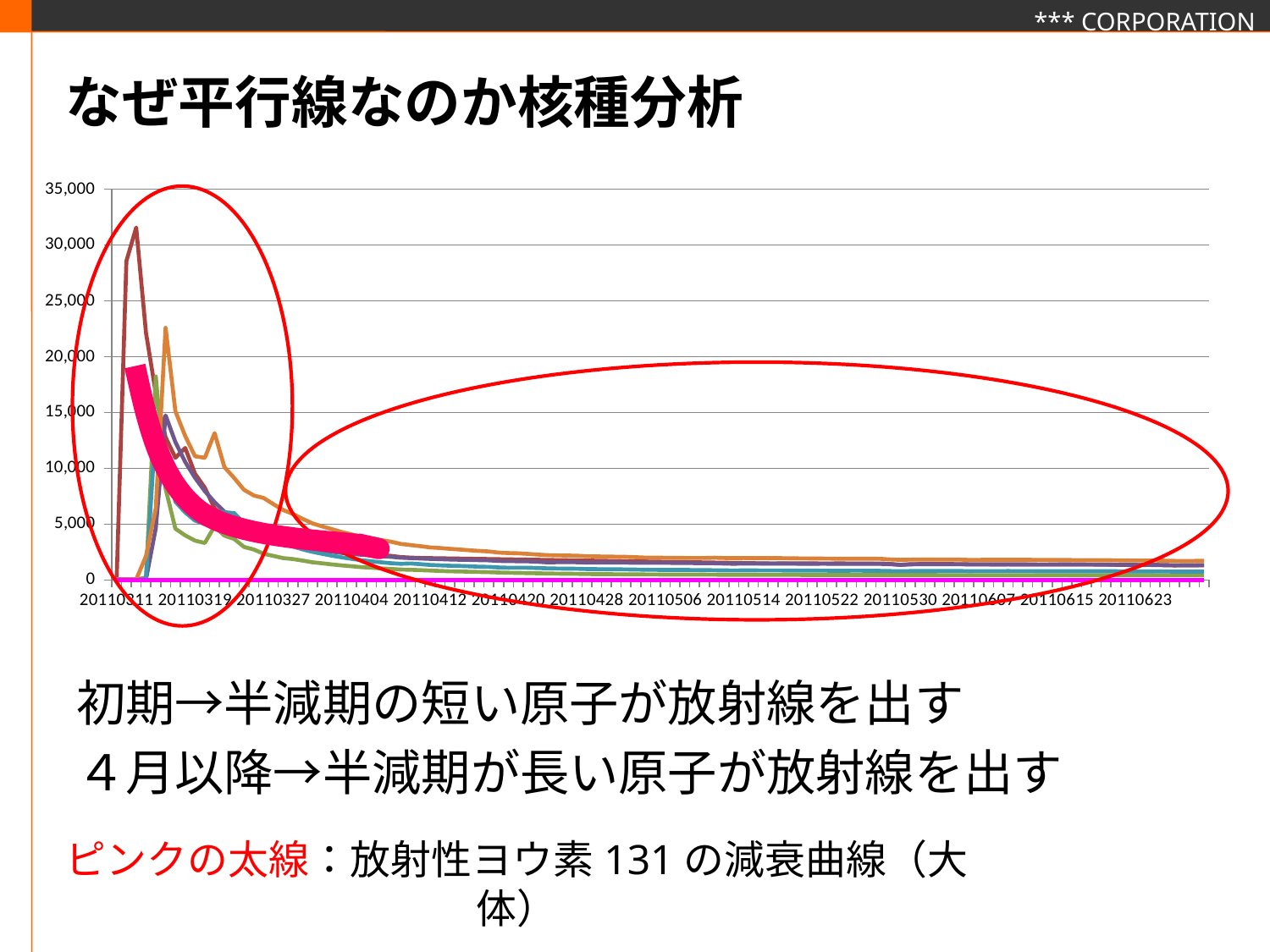
What is the highest value shown on the vertical axis of the chart? 35,000 Which line reaches the highest peak on the chart, the brown line or the orange line? the brown line What is the first date label on the horizontal axis of the chart? 20110311 Is the peak value of the orange line greater or less than 20,000? greater How many date labels are printed along the horizontal axis of the chart? 14 After the initial peak in March, do the plotted lines rise or fall as the dates move to the right? fall Are the values of all the lines at 20110514 greater or less than 5,000? less What kind of chart is shown on the slide? line chart What is the last date label on the horizontal axis of the chart? 20110623 What is the interval between consecutive tick labels on the vertical axis? 5,000 Is the peak value of the brown line greater or less than 30,000? greater